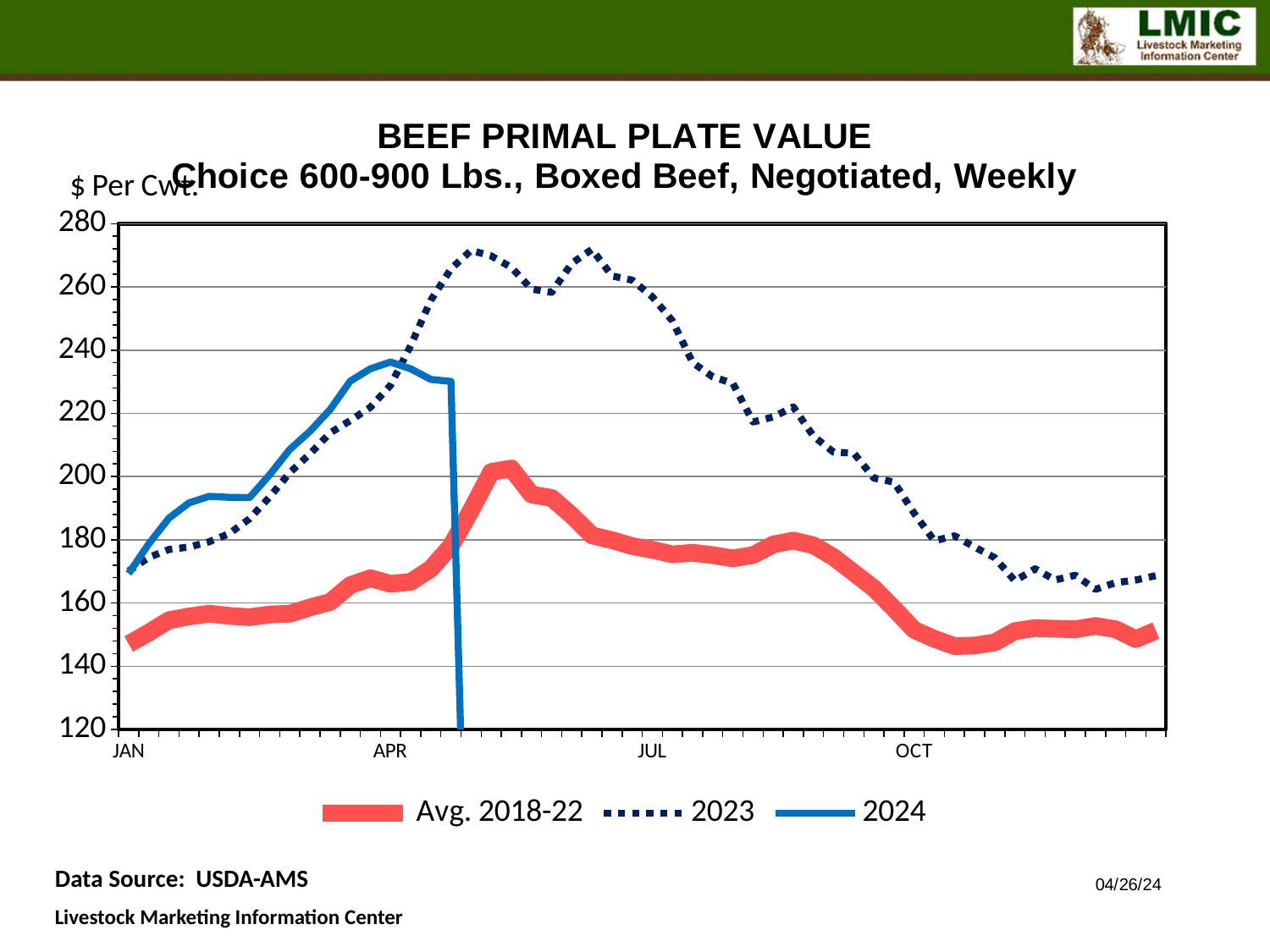
Is the peak value of the 2023 series greater or less than 260? greater How many series does the legend list? 3 Which series reaches the highest value on the chart? 2023 Is the highest value reached by the 2024 series greater or less than 220? greater What kind of chart is shown on the slide? Line chart Does the 2023 series rise or fall between JUL and OCT? Fall What is the label on the y axis of the chart? $ Per Cwt. At JUL, which is higher: the 2023 series or the Avg. 2018-22 series? 2023 Is the value for the Avg. 2018-22 series at JAN greater or less than 160? less Which series is drawn as a dotted line? 2023